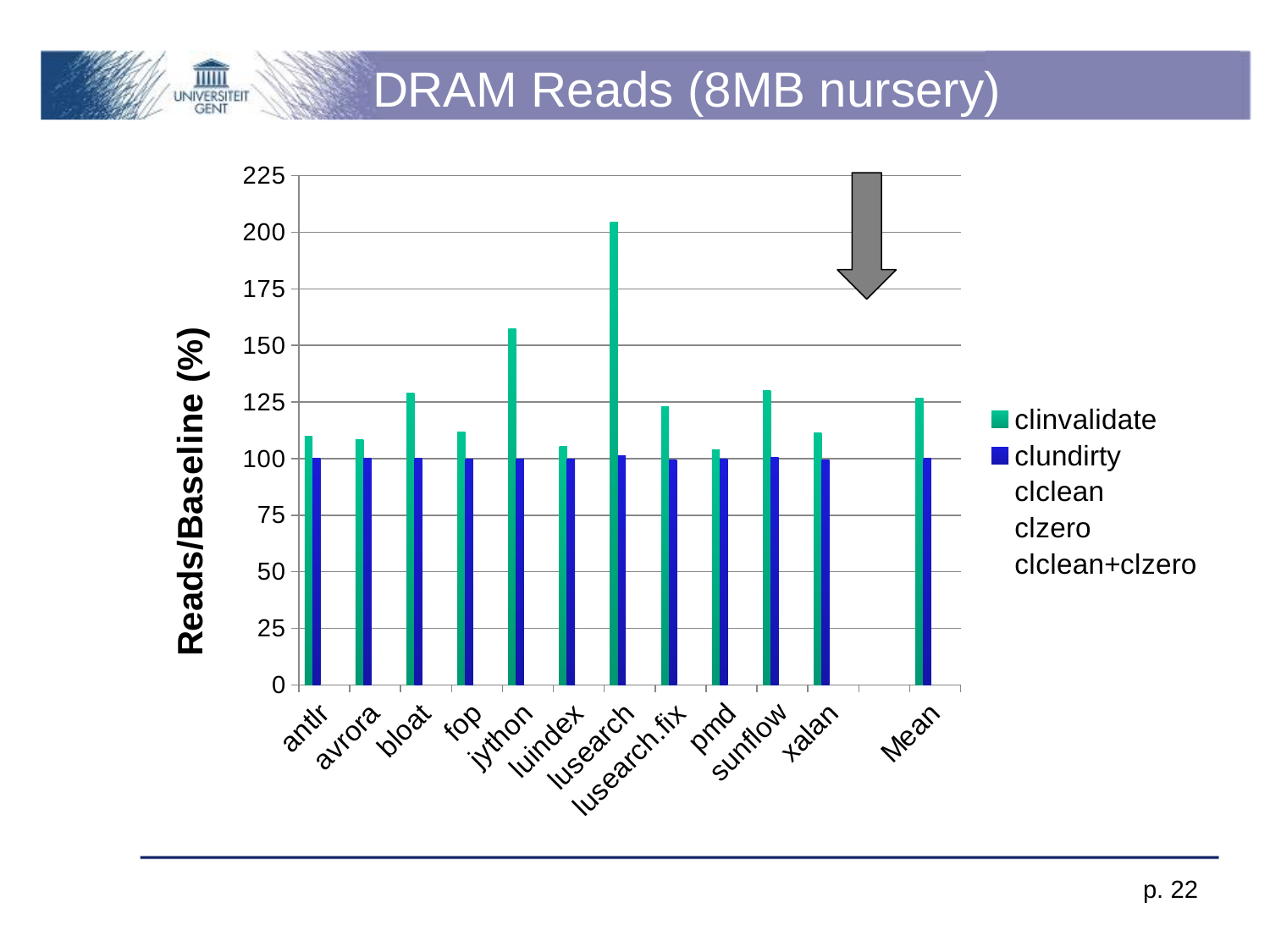
Which category has the highest clinvalidate bar? lusearch Is the clinvalidate value for jython greater or less than 125? greater How many categories are shown along the x axis of the chart? 12 Is the clinvalidate value for Mean greater or less than 100? greater How many entries does the chart's legend list? 5 What is the title of the chart? DRAM Reads (8MB nursery) What is the label on the vertical axis of the chart? Reads/Baseline (%) Which has the larger clinvalidate value, jython or antlr? jython Is the clinvalidate value for antlr greater or less than 125? less What kind of chart is shown on the slide? bar chart Which has the larger clinvalidate value, lusearch or lusearch.fix? lusearch